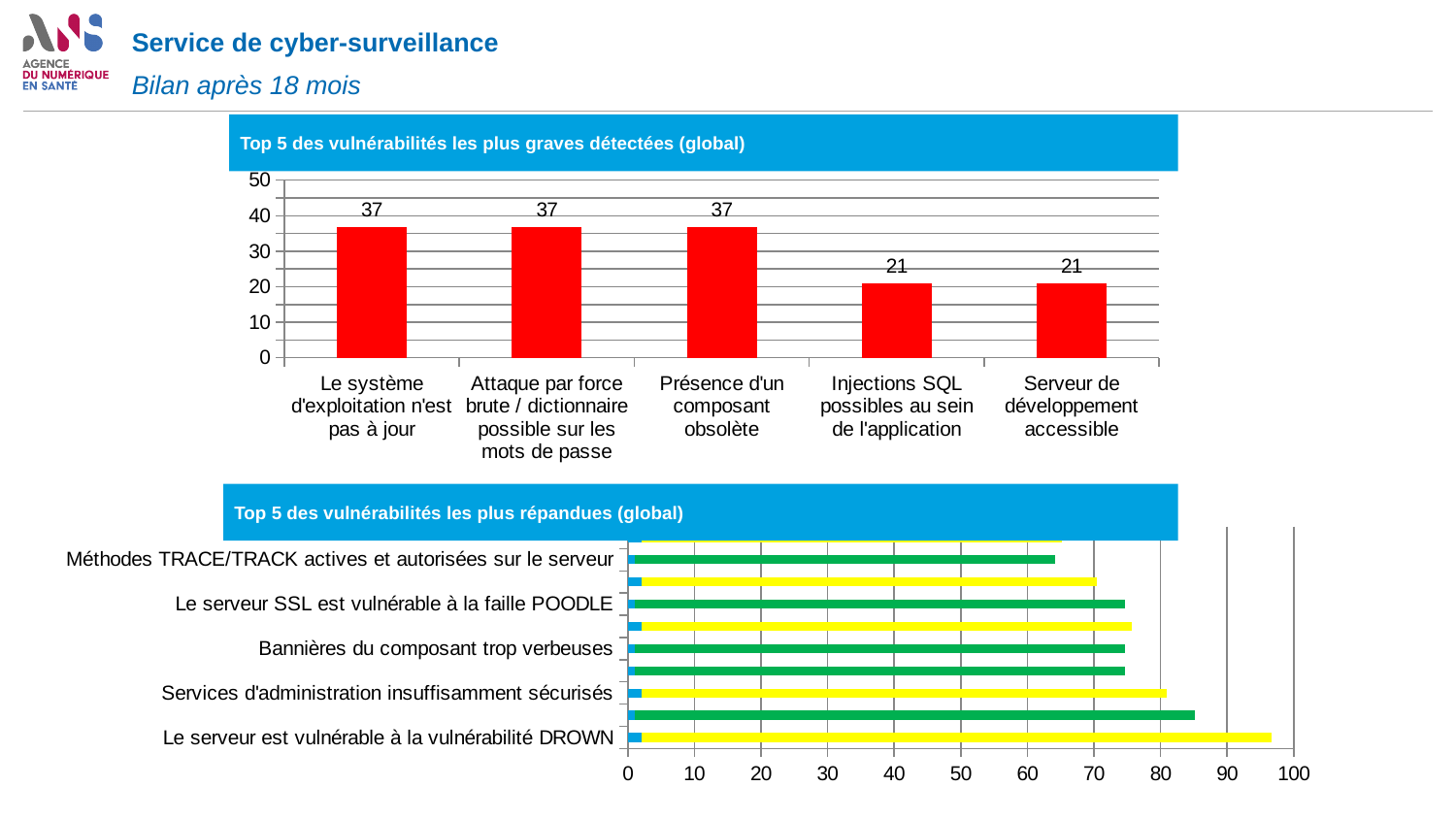
In the chart 'Top 5 des vulnérabilités les plus graves détectées (global)', what is the value for 'Serveur de développement accessible'? 21 In the chart 'Top 5 des vulnérabilités les plus graves détectées (global)', what colour are the bars? Red In the chart 'Top 5 des vulnérabilités les plus graves détectées (global)', which is larger: the value for 'Attaque par force brute / dictionnaire possible sur les mots de passe' or the value for 'Serveur de développement accessible'? Attaque par force brute / dictionnaire possible sur les mots de passe What kind of chart is 'Top 5 des vulnérabilités les plus graves détectées (global)'? Bar chart In the chart 'Top 5 des vulnérabilités les plus répandues (global)', is the yellow bar for 'Le serveur est vulnérable à la vulnérabilité DROWN' greater or less than 90? greater How many categories are shown in the chart 'Top 5 des vulnérabilités les plus graves détectées (global)'? 5 What kind of chart is 'Top 5 des vulnérabilités les plus répandues (global)'? Bar chart In the chart 'Top 5 des vulnérabilités les plus graves détectées (global)', what is the value for 'Présence d'un composant obsolète'? 37 In the chart 'Top 5 des vulnérabilités les plus graves détectées (global)', what is the value for 'Injections SQL possibles au sein de l'application'? 21 In the chart 'Top 5 des vulnérabilités les plus répandues (global)', is the green bar for 'Méthodes TRACE/TRACK actives et autorisées sur le serveur' greater or less than 70? less In the chart 'Top 5 des vulnérabilités les plus graves détectées (global)', what is the difference between the value for 'Le système d'exploitation n'est pas à jour' and the value for 'Injections SQL possibles au sein de l'application'? 16